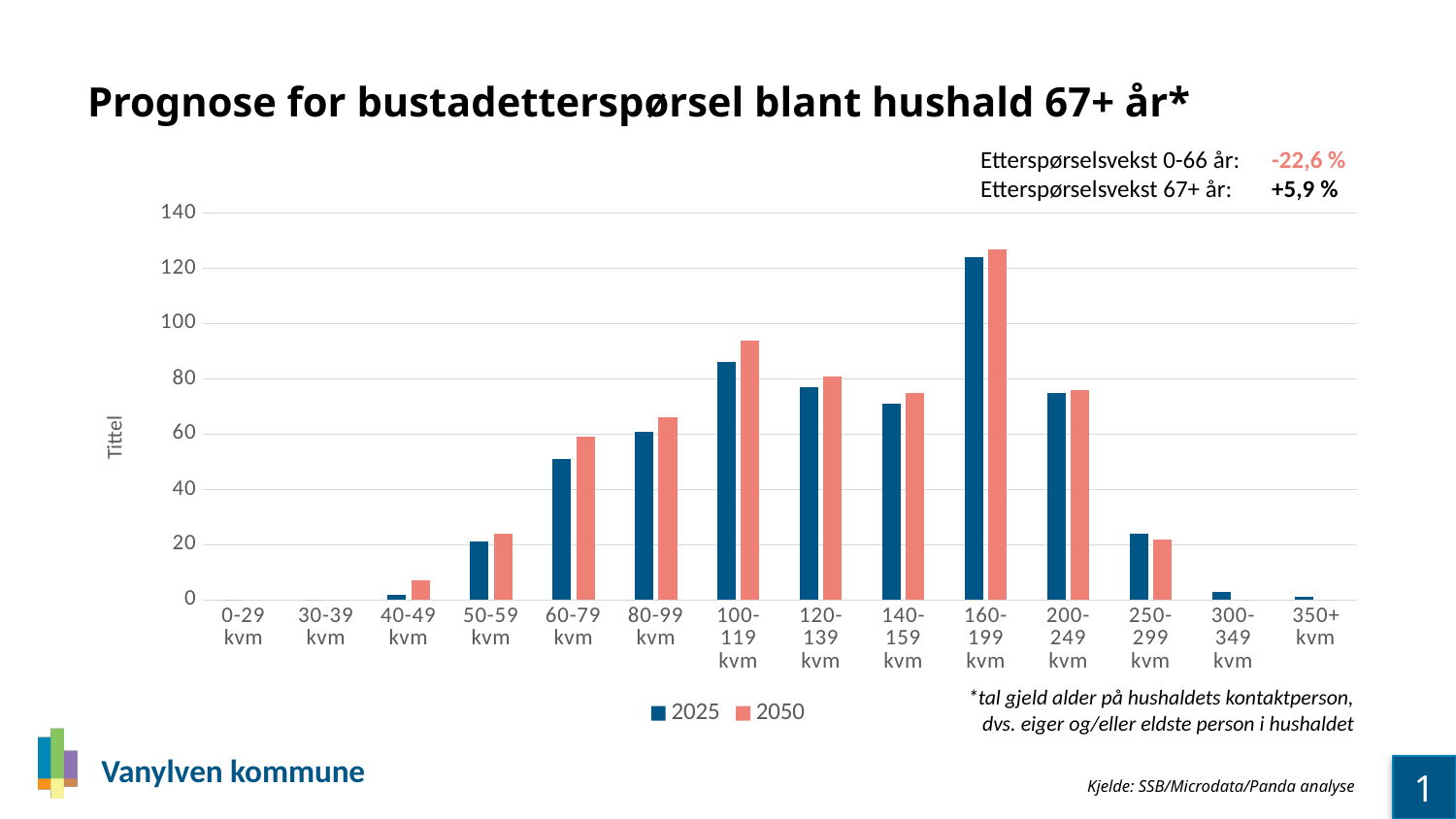
Which category has the highest value for the 2050 series? 160-199 kvm How many size categories are shown on the x axis of the chart? 14 Is the 2050 value for 100-119 kvm greater or less than 100? less For the 100-119 kvm category, which series has the larger value, 2025 or 2050? 2050 How many series does the chart's legend list? 2 Is the 2050 value for 60-79 kvm greater or less than 40? greater Is the 2025 value for 160-199 kvm greater or less than 100? greater What is the title of the chart on the slide? Prognose for bustadetterspørsel blant hushald 67+ år* What kind of chart is shown on the slide? bar chart What are the two series named in the chart's legend? 2025 and 2050 Which category has the highest value for the 2025 series? 160-199 kvm